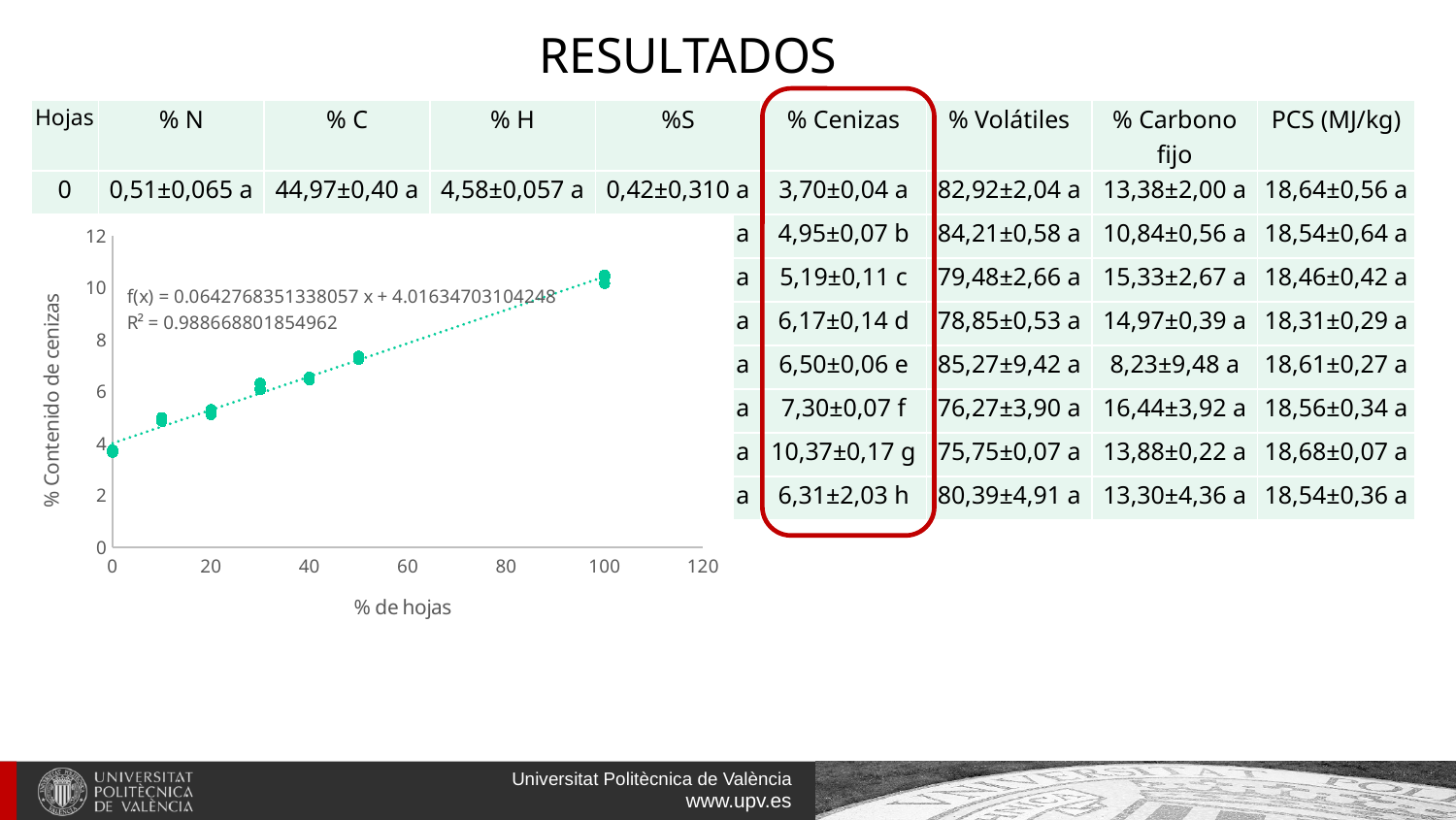
At which % de hojas value is the plotted % Contenido de cenizas highest? 100 What kind of chart is shown on the slide? scatter chart What R² value is printed on the chart? 0.988668801854962 Is the plotted value at 20 % de hojas greater or less than 6? less Is the plotted value at 40 % de hojas greater or less than 8? less Which has the larger plotted % Contenido de cenizas: 10 % de hojas or 50 % de hojas? 50 % de hojas At which % de hojas value is the plotted % Contenido de cenizas lowest? 0 Do the plotted values of % Contenido de cenizas rise or fall as % de hojas increases? rise What is the title of the x axis of the chart? % de hojas Is the plotted value at 50 % de hojas greater or less than 6? greater Which has the larger plotted % Contenido de cenizas: 100 % de hojas or 0 % de hojas? 100 % de hojas